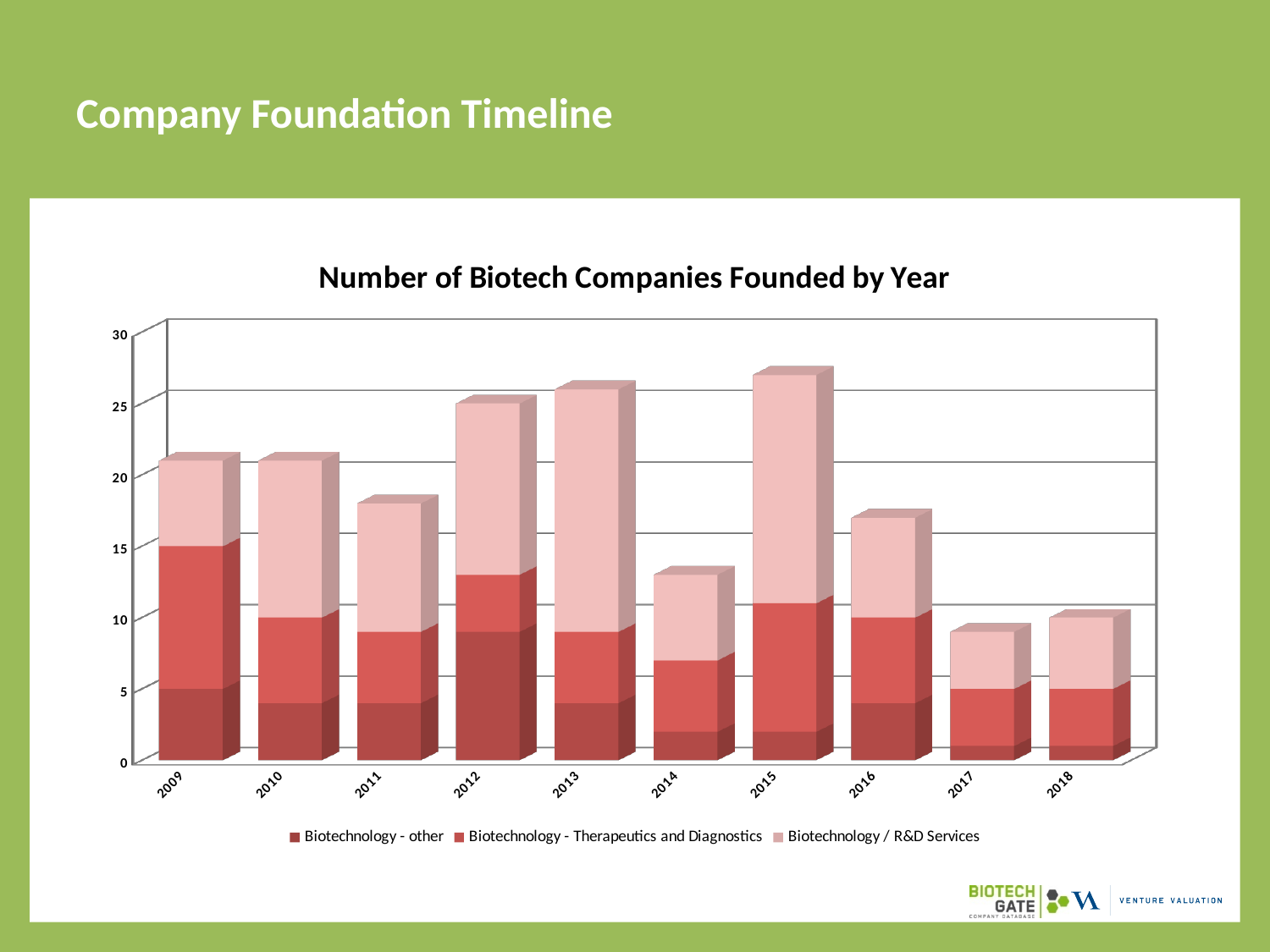
Which legend entry is shown in the lightest pink colour? Biotechnology / R&D Services What is the title of the chart? Number of Biotech Companies Founded by Year Which year has the larger total, 2013 or 2014? 2013 How many series does the legend list? 3 Which year has the tallest stacked bar? 2015 How many years are shown on the x axis? 10 Is the total value for 2017 greater or less than 10? less Do the total values rise or fall from 2015 to 2018? fall Is the total value for 2014 greater or less than 15? less Is the total value for 2015 greater or less than 25? greater What type of chart is shown on the slide? Bar chart